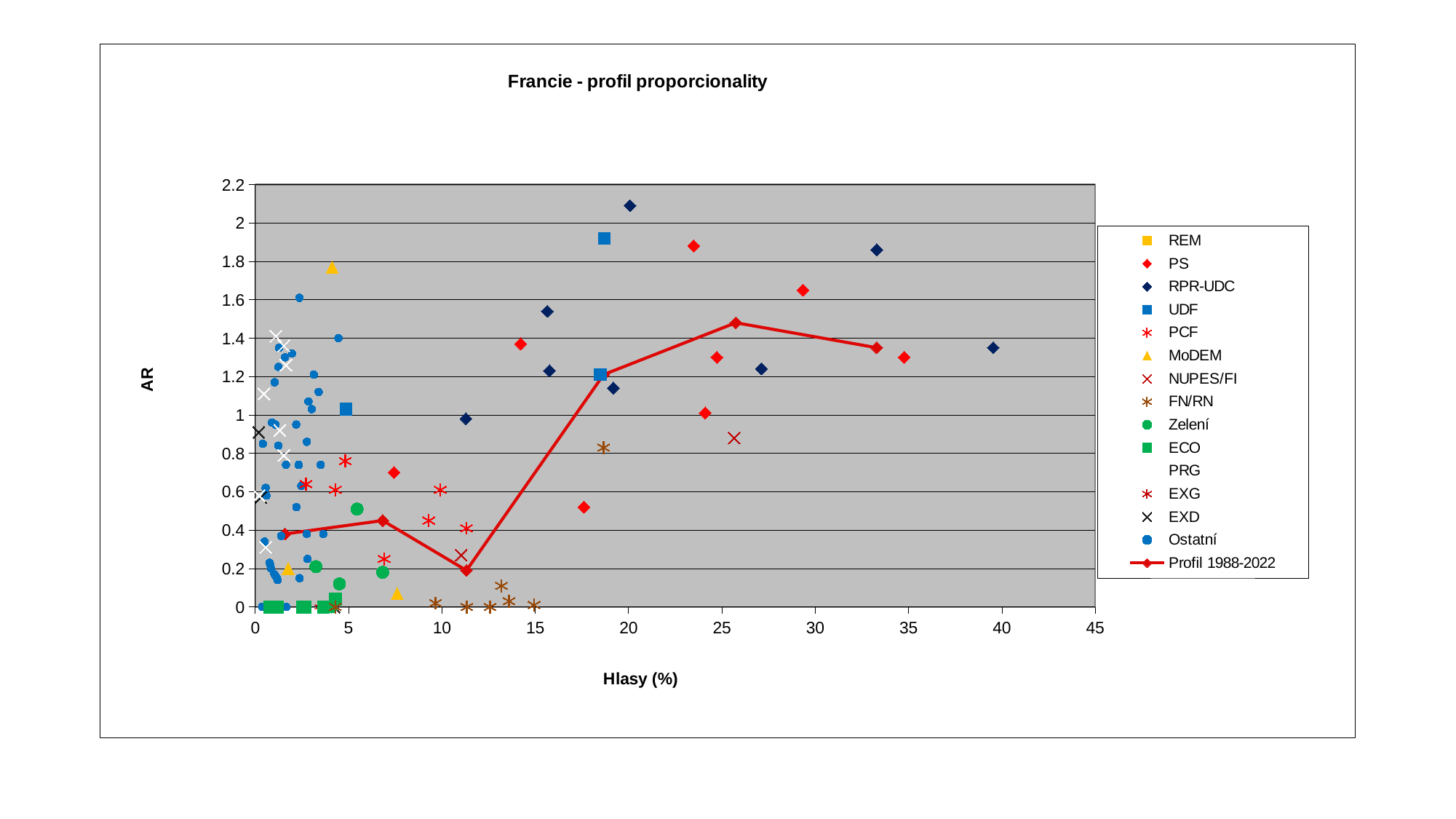
What is the title of the chart? Francie - profil proporcionality Which series contains the point with the highest AR value on the chart? RPR-UDC Which is higher on the AR axis: the Profil 1988-2022 point near 25% or the one near 33% on the Hlasy axis? the point near 25% Is the lowest point of the Profil 1988-2022 line greater or less than 0.4 on the AR axis? less Is the peak of the Profil 1988-2022 line greater or less than 1.6 on the AR axis? less What kind of chart is shown on the slide? scatter chart Does the Profil 1988-2022 line rise or fall between roughly 11% and 25% on the Hlasy axis? rise What is the label of the horizontal axis? Hlasy (%) How many points make up the Profil 1988-2022 line? 6 Is the highest point on the chart greater or less than 2 on the AR axis? greater How many entries does the chart's legend list? 15 What is the maximum value shown on the Hlasy (%) axis? 45